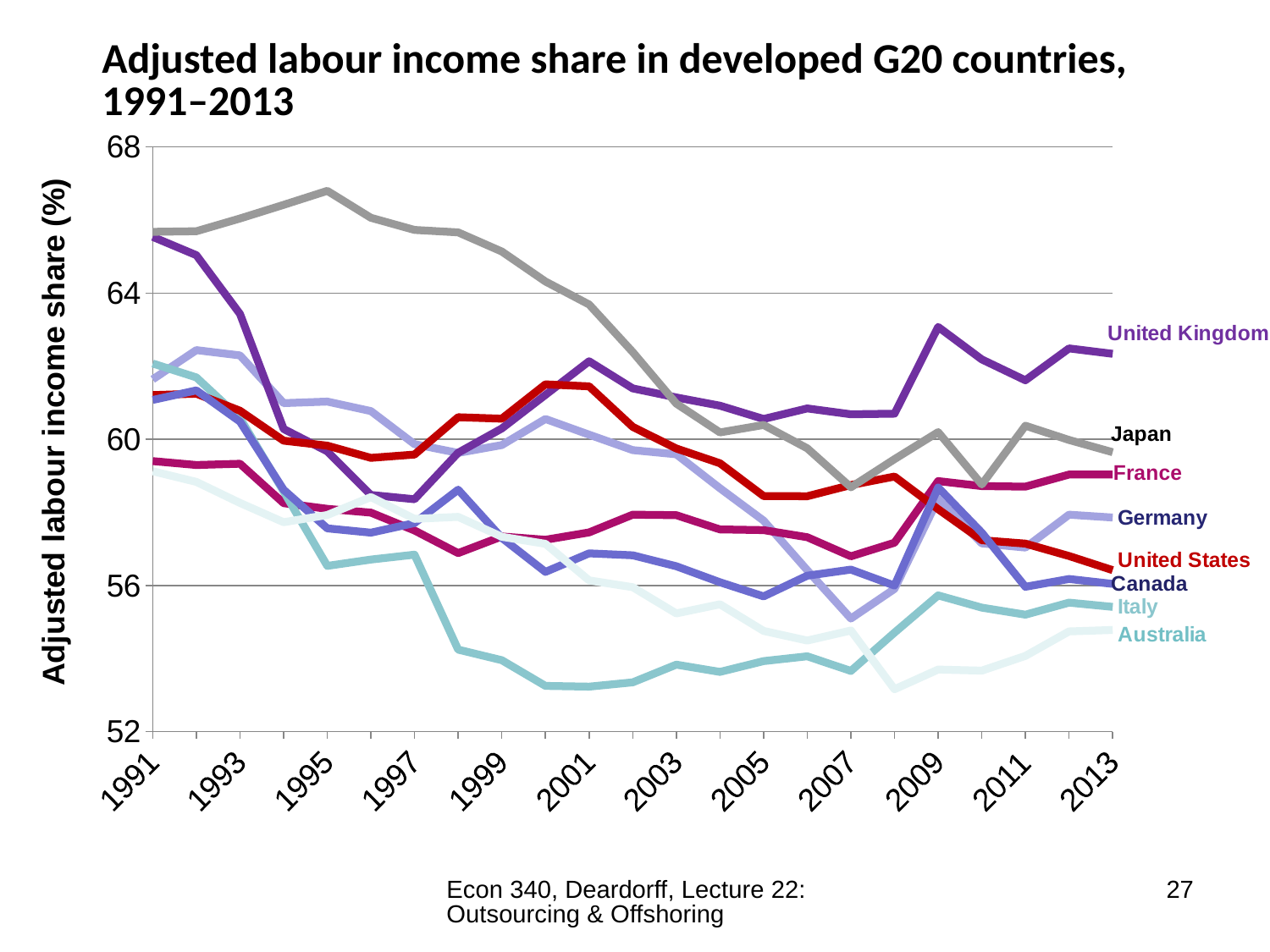
Is the value for Japan in 1995 greater or less than 64? greater What kind of chart is shown on the slide? line chart Does the value for Japan rise or fall between 1995 and 2007? fall In 2001, which is larger: the value for Italy or the value for Australia? Australia Is the value for Germany in 2007 greater or less than 56? less What is the label on the vertical axis of the chart? Adjusted labour income share (%) How many countries (series) are plotted on the chart? 8 In 2001, which is larger: the value for Japan or the value for the United Kingdom? Japan Which country has the highest adjusted labour income share in 2013? United Kingdom Which country has the lowest adjusted labour income share in 2013? Australia Is the value for the United Kingdom in 2013 greater or less than 60? greater